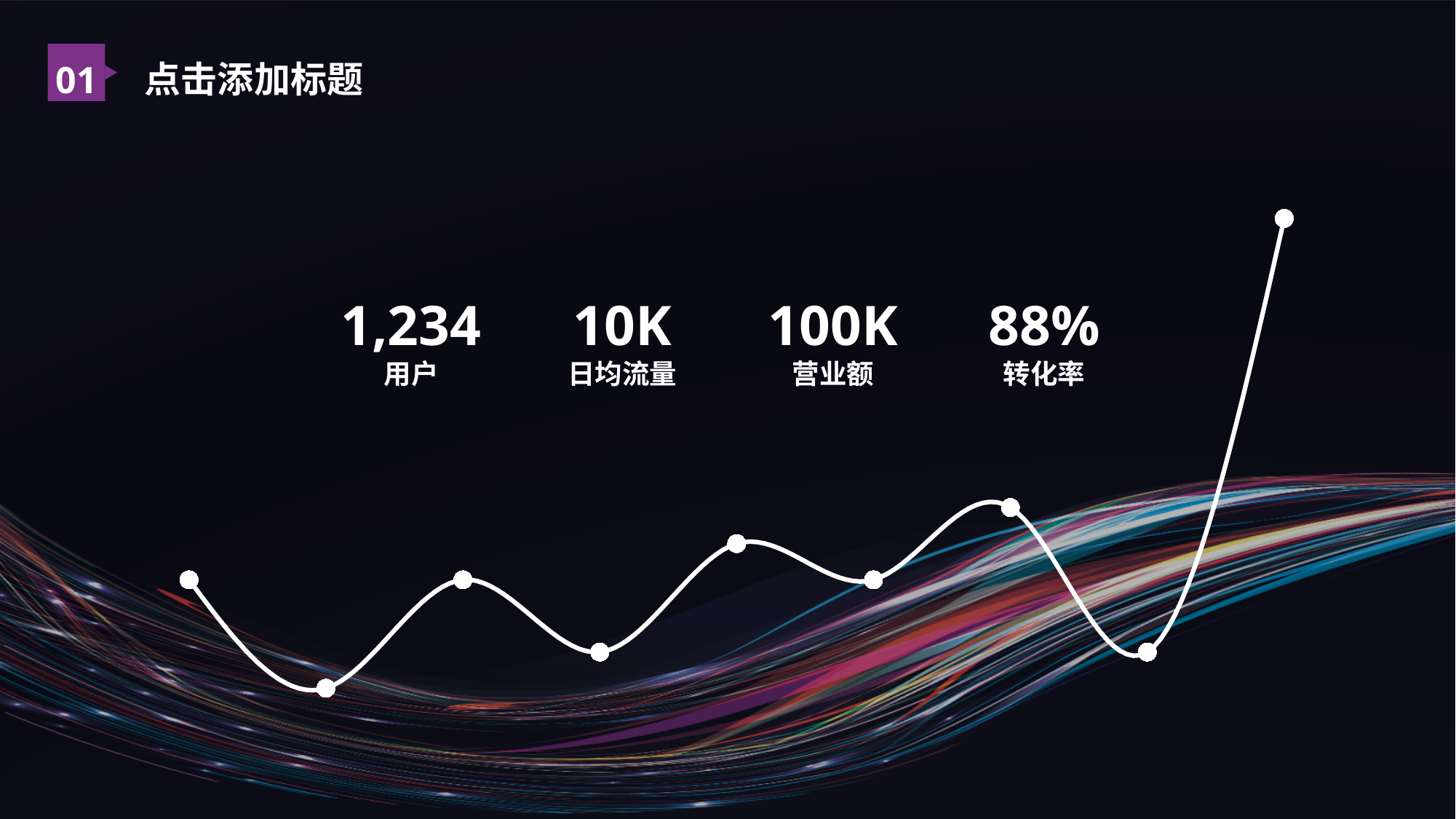
How many lines (series) are plotted on the chart? 1 Which data point on the line chart is the lowest? the second point from the left How many data points are plotted on the line chart? 9 Does the line rise or fall between the seventh point and the eighth point from the left? fall Is the second point from the left higher or lower than the first point? lower Is the last (rightmost) point higher or lower than the first (leftmost) point? higher What colour is the plotted line on the chart? white Does the line rise or fall between the second-to-last point and the last point? rise Which data point on the line chart is the highest? the last (rightmost) point Does the chart display a legend? no What kind of chart is shown on the slide? line chart